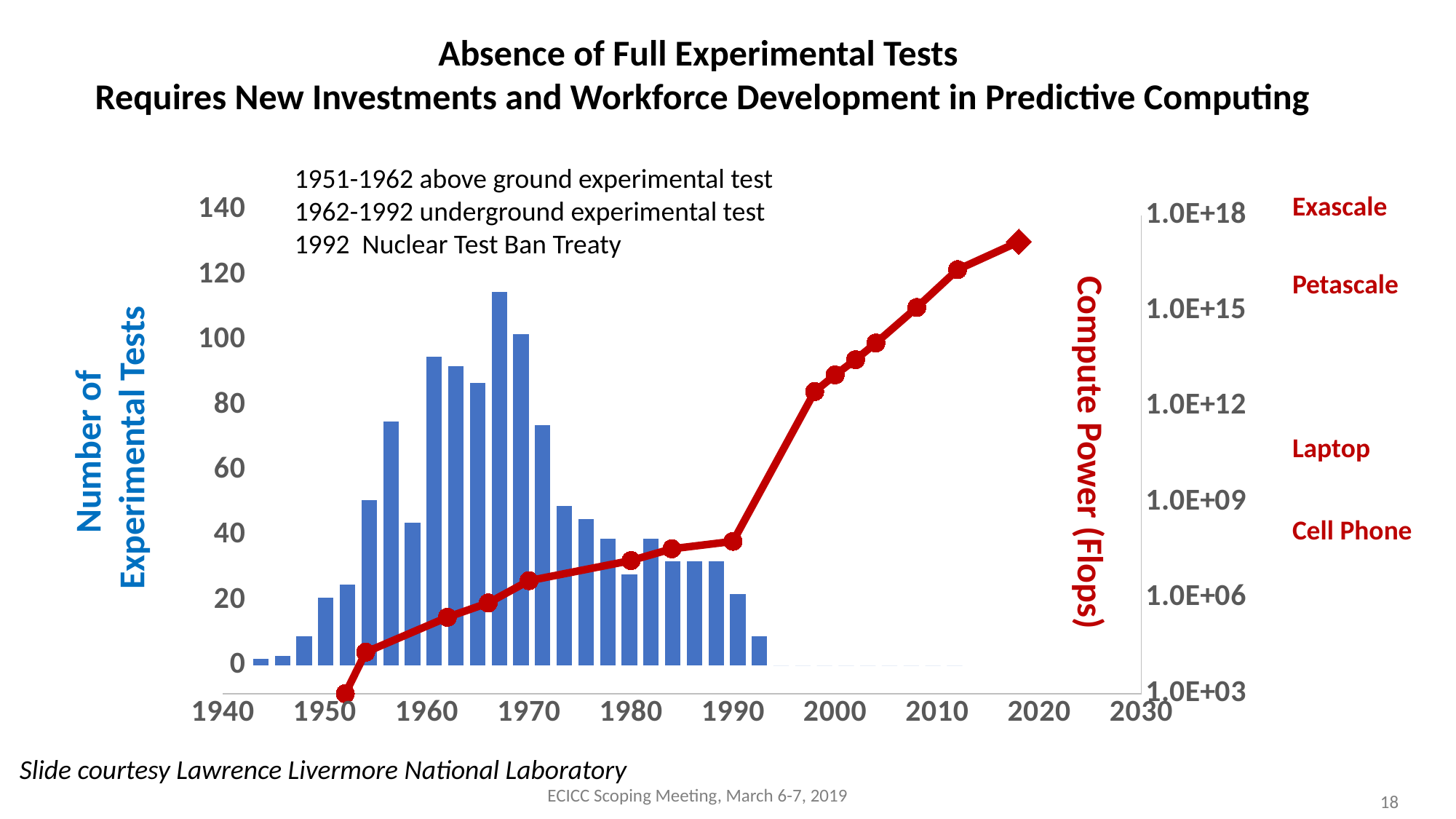
Do the blue bars rise or fall from the 1970s to the early 1990s? Fall What is the title of the right vertical axis? Compute Power (Flops) Is the compute power at the rightmost red point (around 2018) greater or less than 1.0E+15 flops? greater Is the last blue bar (just before the 1992 test ban) greater or less than 20 experimental tests? less Which is taller: the tallest blue bar in the 1960s or the tallest blue bar in the 1970s? The tallest bar in the 1960s Is the compute power at the red point around 1990 greater or less than 1.0E+09 flops? less What is the title of the left vertical axis? Number of Experimental Tests Does the red compute power line rise or fall as the years increase? Rises In which decade does the tallest blue bar fall? 1960s What kind of chart is shown on the slide? A combined bar and line chart